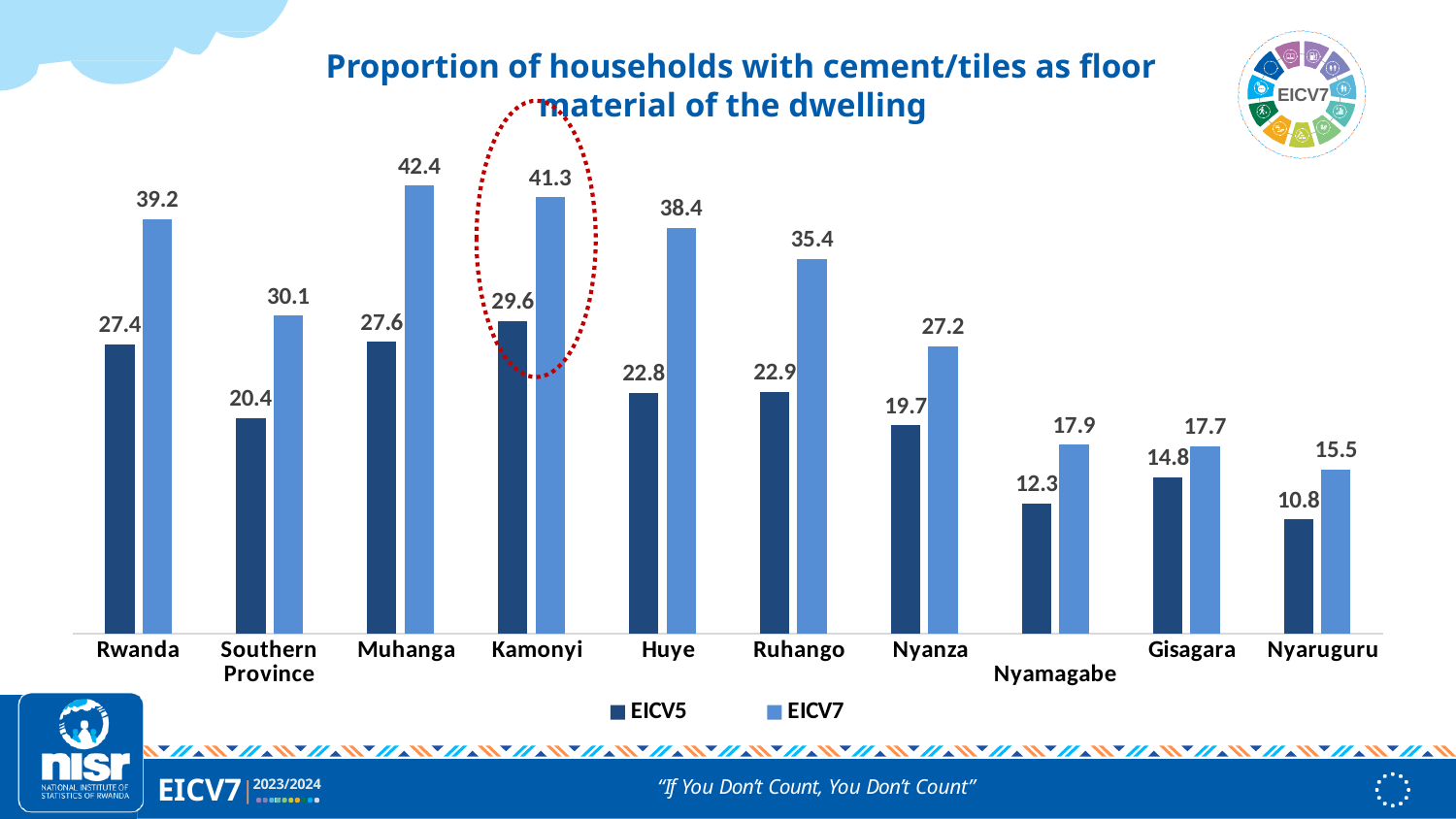
Which is larger, the EICV7 value for Ruhango or the EICV7 value for Nyanza? Ruhango Which category has the lowest EICV5 value? Nyaruguru What kind of chart is shown on the slide? Bar chart What is the difference between the EICV7 values for Rwanda and Nyanza? 12.0 What is the EICV7 value for Huye? 38.4 What is the difference between the EICV7 and EICV5 values for Kamonyi? 11.7 Which category is highlighted with a red dotted circle? Kamonyi Which category has the highest EICV7 value? Muhanga What is the EICV5 value for Southern Province? 20.4 How many categories are shown on the x axis? 10 What is the EICV7 value for Kamonyi? 41.3 How many series does the legend list? 2